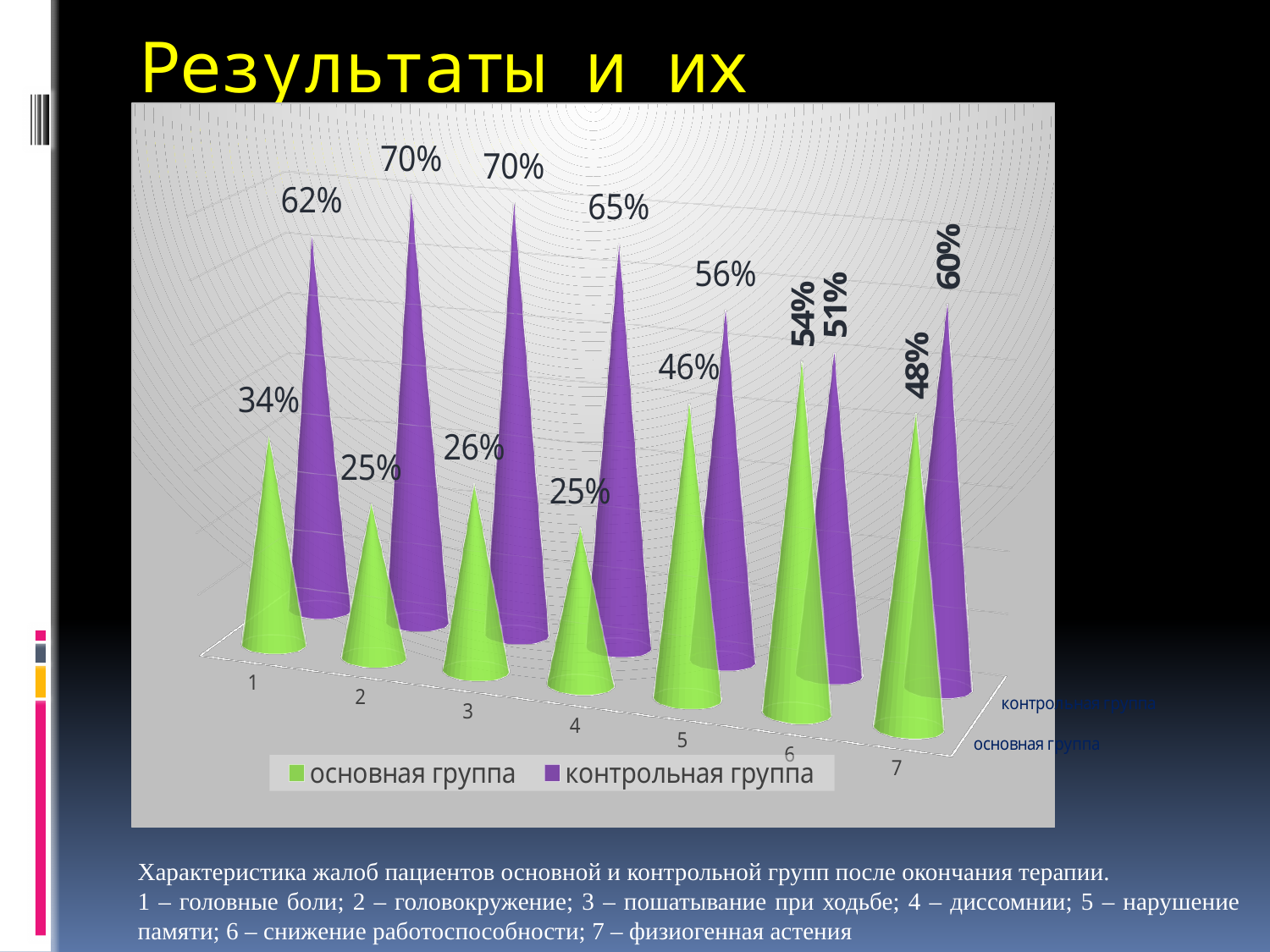
Which category has the lowest value in the контрольная группа series? 6 What is the value for category 4 in the контрольная группа series? 65% How many categories are shown on the x axis? 7 Which colour represents the контрольная группа series? purple What is the difference between the контрольная группа and основная группа values for category 2? 45% What kind of chart is shown on the slide? bar chart What is the value for category 1 in the основная группа series? 34% What is the value for category 6 in the основная группа series? 54% What is the value for category 7 in the контрольная группа series? 60% How many series does the legend list? 2 For category 6, which series has the larger value, основная группа or контрольная группа? основная группа Which category has the highest value in the основная группа series? 6